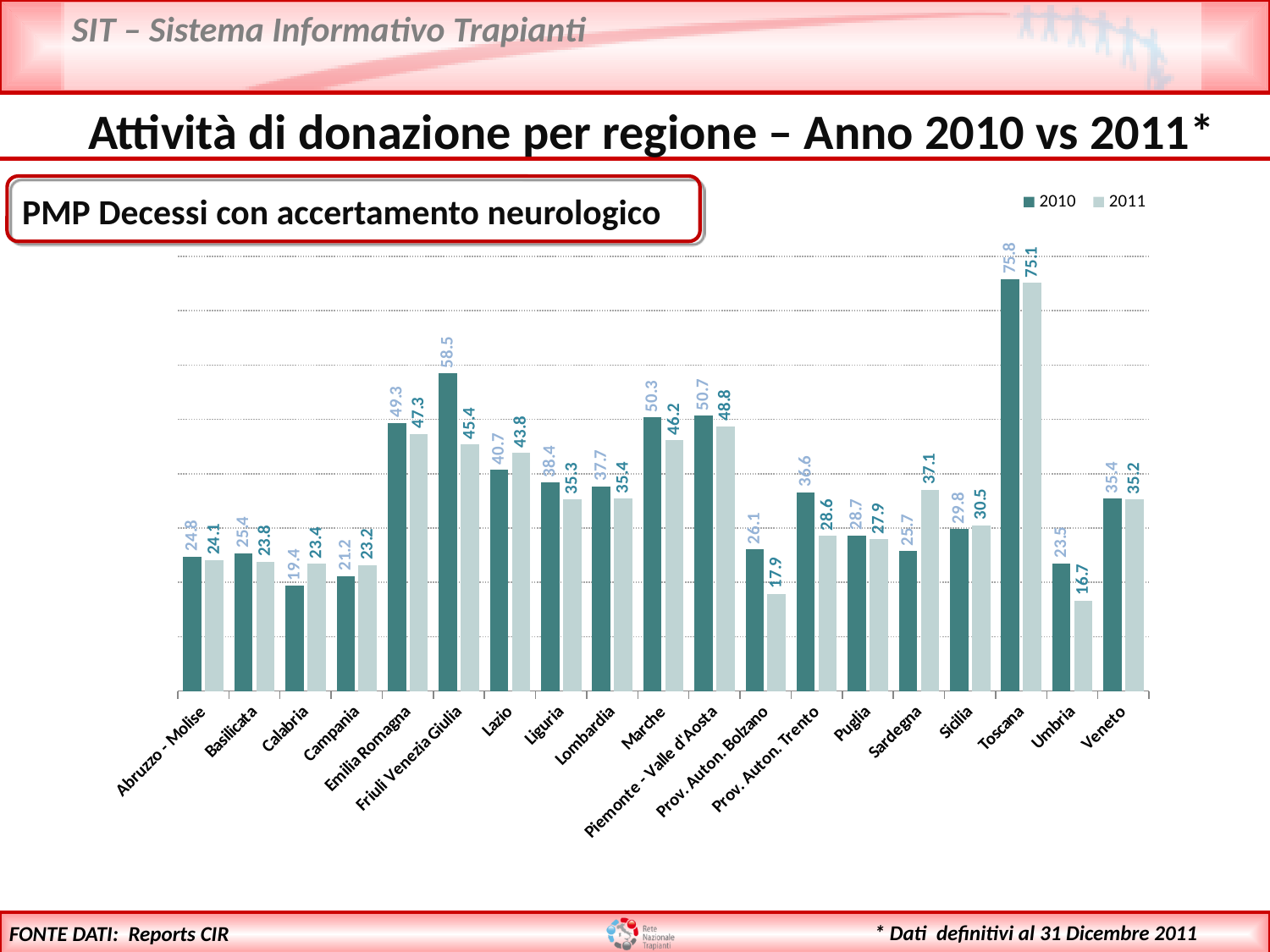
What kind of chart is shown on the slide? Bar chart How many regions are shown on the x axis? 19 Which region has the highest 2011 value? Toscana What is the difference between the 2010 and 2011 values for Friuli Venezia Giulia? 13.1 What is the 2010 value for Toscana? 75.8 Which region has the lowest 2010 value? Calabria How many series does the legend list? 2 What is the 2011 value for Sardegna? 37.1 What is the 2011 value for Friuli Venezia Giulia? 45.4 Which region has the lowest 2011 value? Umbria Which is larger for Lazio, the 2010 value or the 2011 value? 2011 What is the 2010 value for Prov. Auton. Bolzano? 26.1